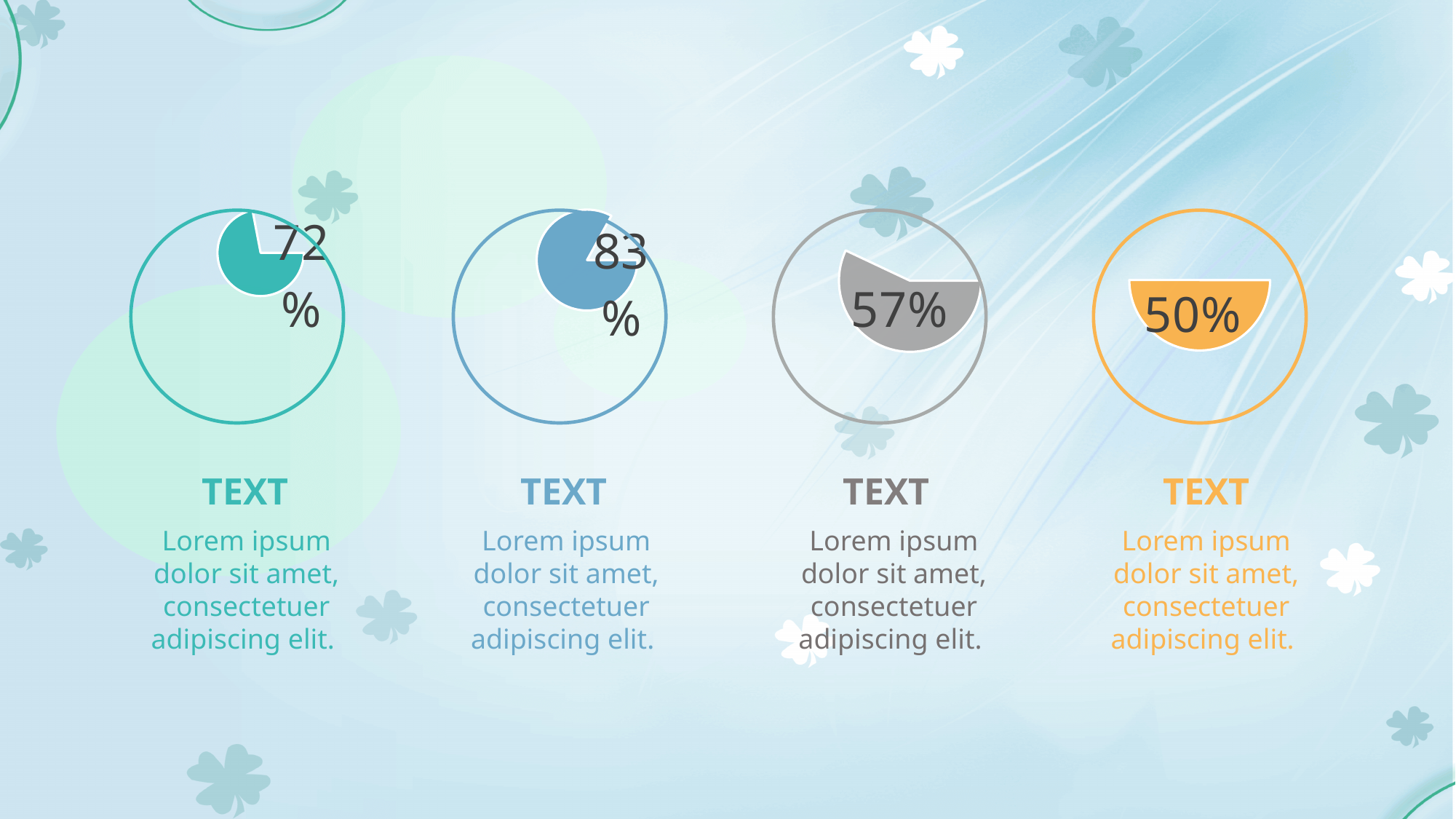
What kind of chart is used for each of the four figures on the slide? Pie chart How many charts are shown on the slide? 4 What is the difference between the value on the grey chart and the value on the orange chart? 7% What value is shown on the leftmost (teal) chart? 72% What is the difference between the value on the blue chart and the value on the teal chart? 11% Which of the four charts shows the highest percentage? The second chart from the left (blue), 83% What value is shown on the second chart from the left (blue)? 83% What value is shown on the third chart from the left (grey)? 57% What colour is the filled slice of the rightmost chart? Orange Which of the four charts shows the lowest percentage? The rightmost (orange) chart, 50% Which is larger, the value on the teal chart or the value on the grey chart? The teal chart (72%) What value is shown on the rightmost (orange) chart? 50%